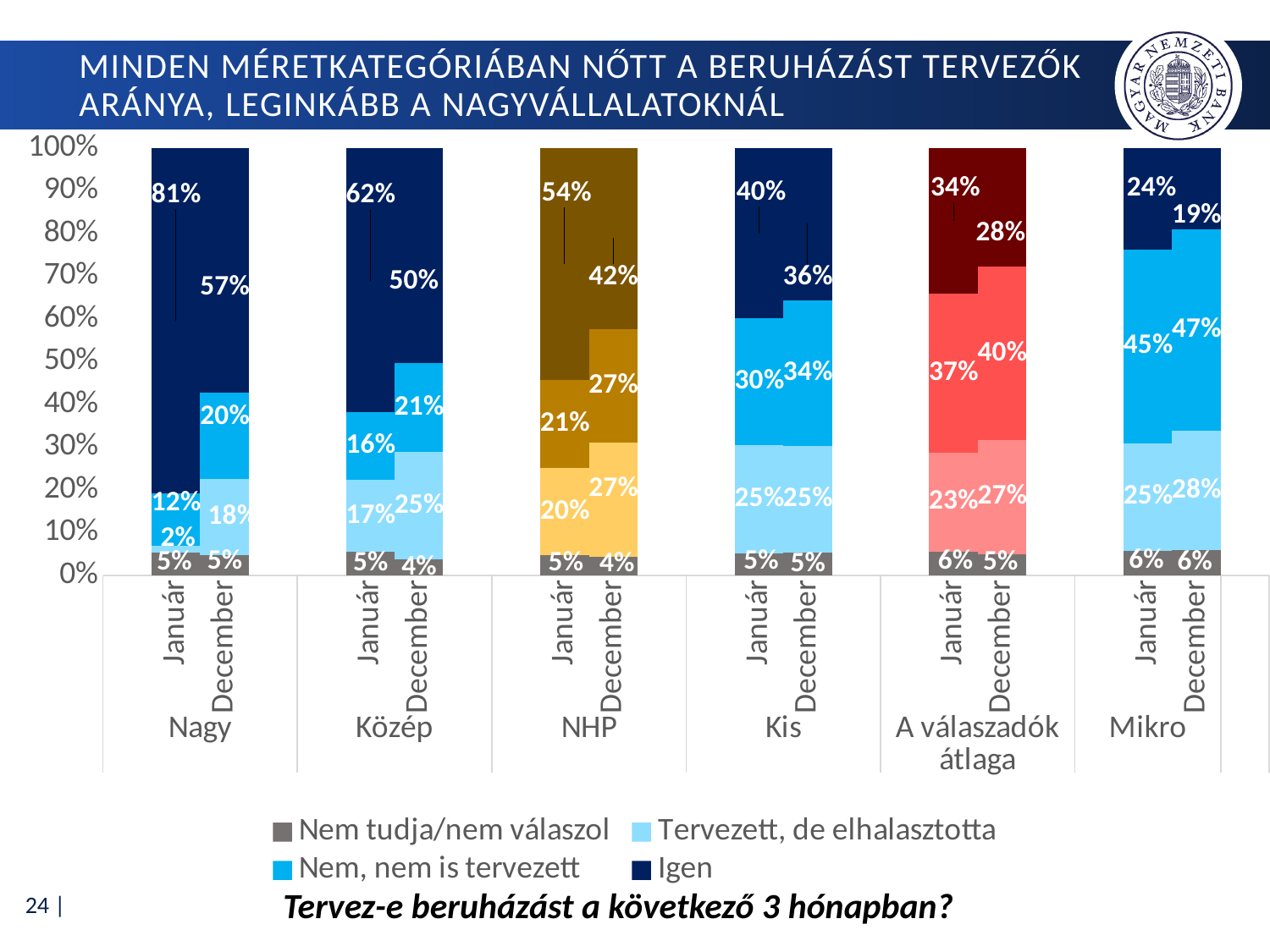
What is the 'Nem tudja/nem válaszol' value for A válaszadók átlaga in Január? 6% Which size category has the highest 'Igen' share in Január? Nagy What is the 'Nem, nem is tervezett' value for Mikro in December? 47% What is the difference between the 'Igen' values for Nagy in Január and December? 24 percentage points What is the 'Igen' value for Nagy in Január? 81% Which size category has the lowest 'Igen' share in December? Mikro What question is written below the legend of the chart? Tervez-e beruházást a következő 3 hónapban? Is the 'Igen' value for Közép in Január larger or smaller than the 'Igen' value for Kis in Január? Larger How many size categories (groups) are shown on the x axis? 6 What type of chart is shown on the slide? Stacked bar chart How many series does the legend list? 4 What is the 'Tervezett, de elhalasztotta' value for NHP in December? 27%